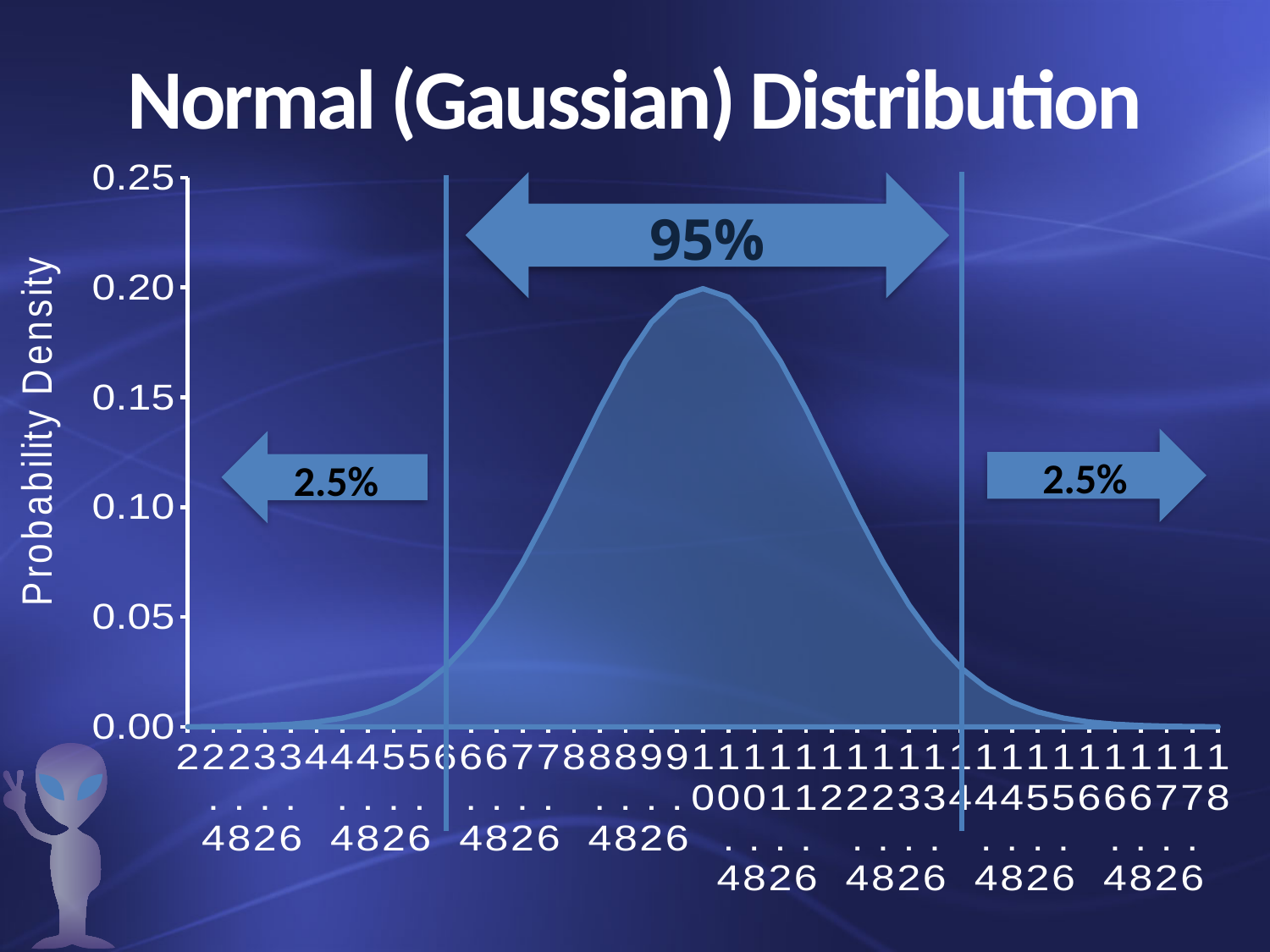
What percentage is labelled on the large double-headed arrow between the two vertical lines? 95% What is the title of the chart on the slide? Normal (Gaussian) Distribution What percentage is labelled on the arrow pointing left, outside the left vertical line? 2.5% Does the curve rise or fall as it moves from the centre toward the right edge of the x axis? fall Is the peak of the curve greater or less than 0.15? greater What is the lowest tick value shown on the vertical axis? 0.00 What is the label on the vertical axis of the chart? Probability Density What kind of chart is shown on the slide? Area chart What percentage is labelled on the arrow pointing right, outside the right vertical line? 2.5% Does the curve rise or fall as it moves from the left edge toward the centre of the x axis? rise What is the highest tick value shown on the vertical axis? 0.25 Is the peak of the curve greater or less than 0.25? less